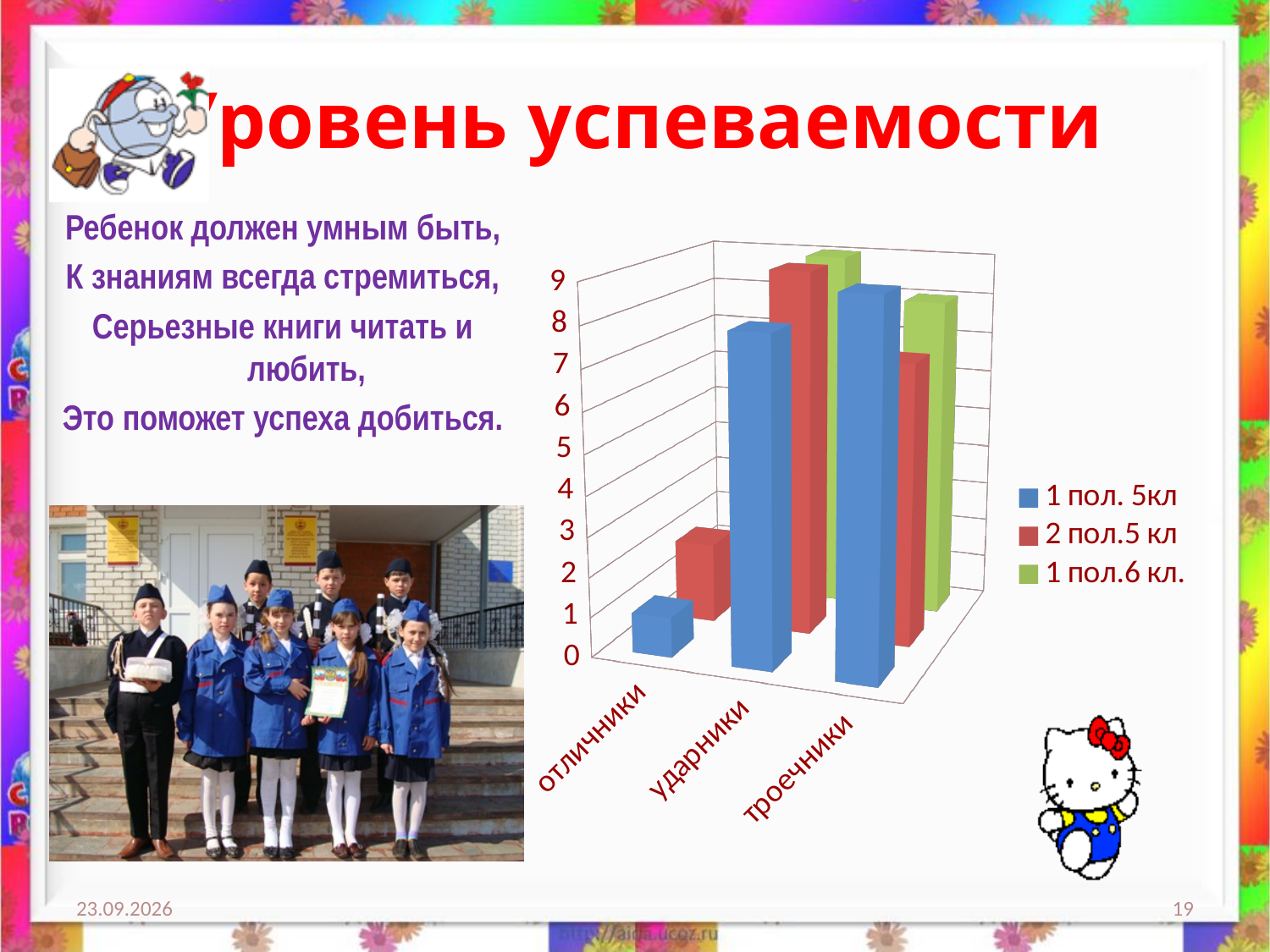
How many series does the chart's legend list? 3 What kind of chart is shown on the slide? bar chart What colour represents the series 1 пол.6 кл. in the chart? green How many categories are shown on the x axis of the chart? 3 What are the three series listed in the chart's legend? 1 пол. 5кл, 2 пол.5 кл, 1 пол.6 кл. Is the value for троечники in the series 1 пол. 5кл greater or less than 5? greater For the series 1 пол. 5кл, which is larger: the value for отличники or the value for ударники? ударники Is the value for отличники in the series 2 пол.5 кл greater or less than 4? less Which category has the lowest value for the series 1 пол. 5кл? отличники Is the value for отличники in the series 1 пол. 5кл greater or less than 4? less Which category has the lowest value for the series 2 пол.5 кл? отличники